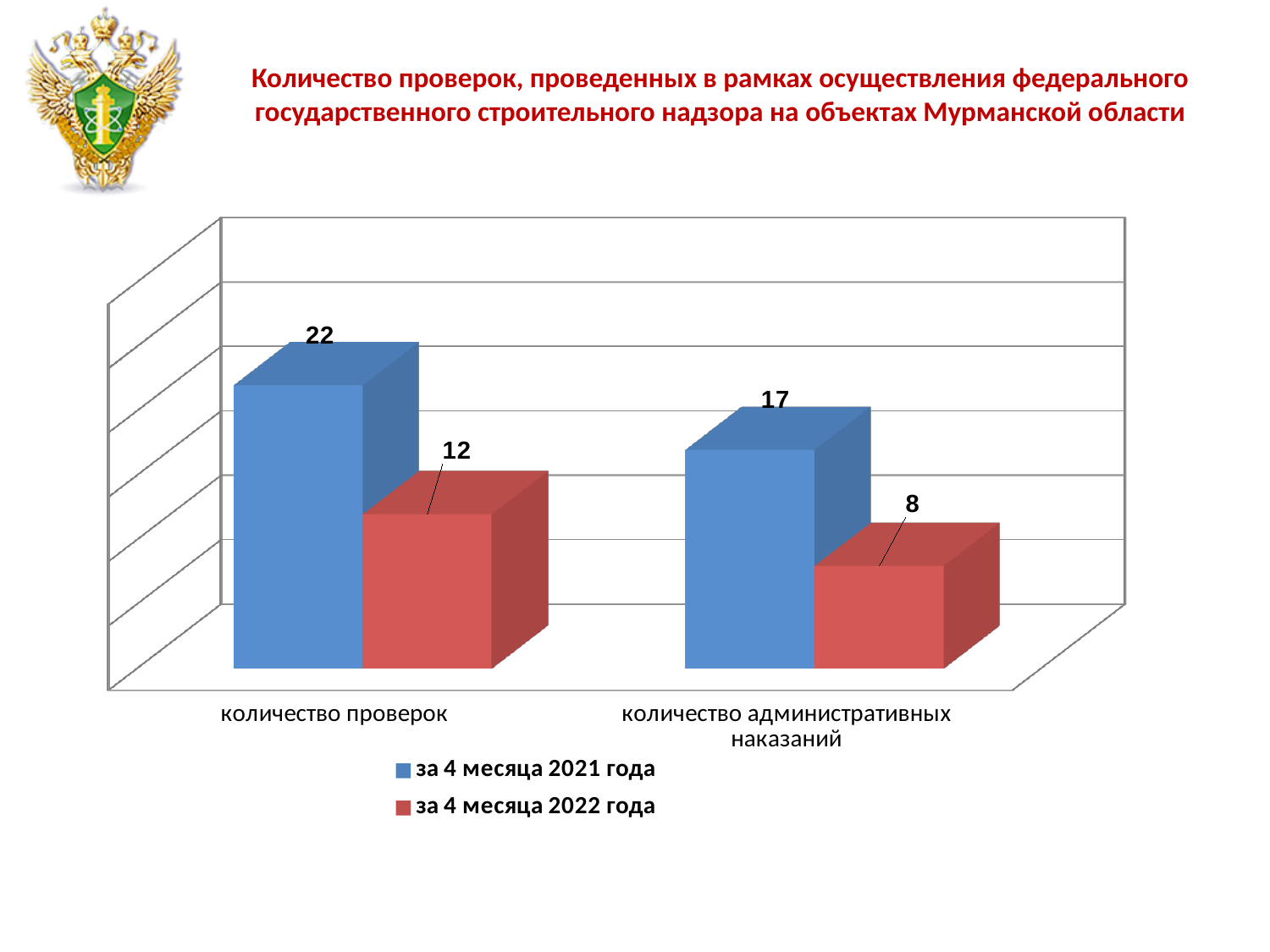
How many series does the legend list? 2 How many categories are shown on the x axis? 2 What is the value for "количество административных наказаний" in the series "за 4 месяца 2022 года"? 8 Which category has the lowest value in the series "за 4 месяца 2022 года"? количество административных наказаний What is the value for "количество административных наказаний" in the series "за 4 месяца 2021 года"? 17 What kind of chart is shown on the slide? bar chart What is the difference between the 2021 and 2022 values for "количество административных наказаний"? 9 What is the value for "количество проверок" in the series "за 4 месяца 2022 года"? 12 What is the difference between the 2021 and 2022 values for "количество проверок"? 10 Which is larger: the 2022 value for "количество проверок" or the 2022 value for "количество административных наказаний"? количество проверок Which category has the highest value in the series "за 4 месяца 2021 года"? количество проверок What is the value for "количество проверок" in the series "за 4 месяца 2021 года"? 22